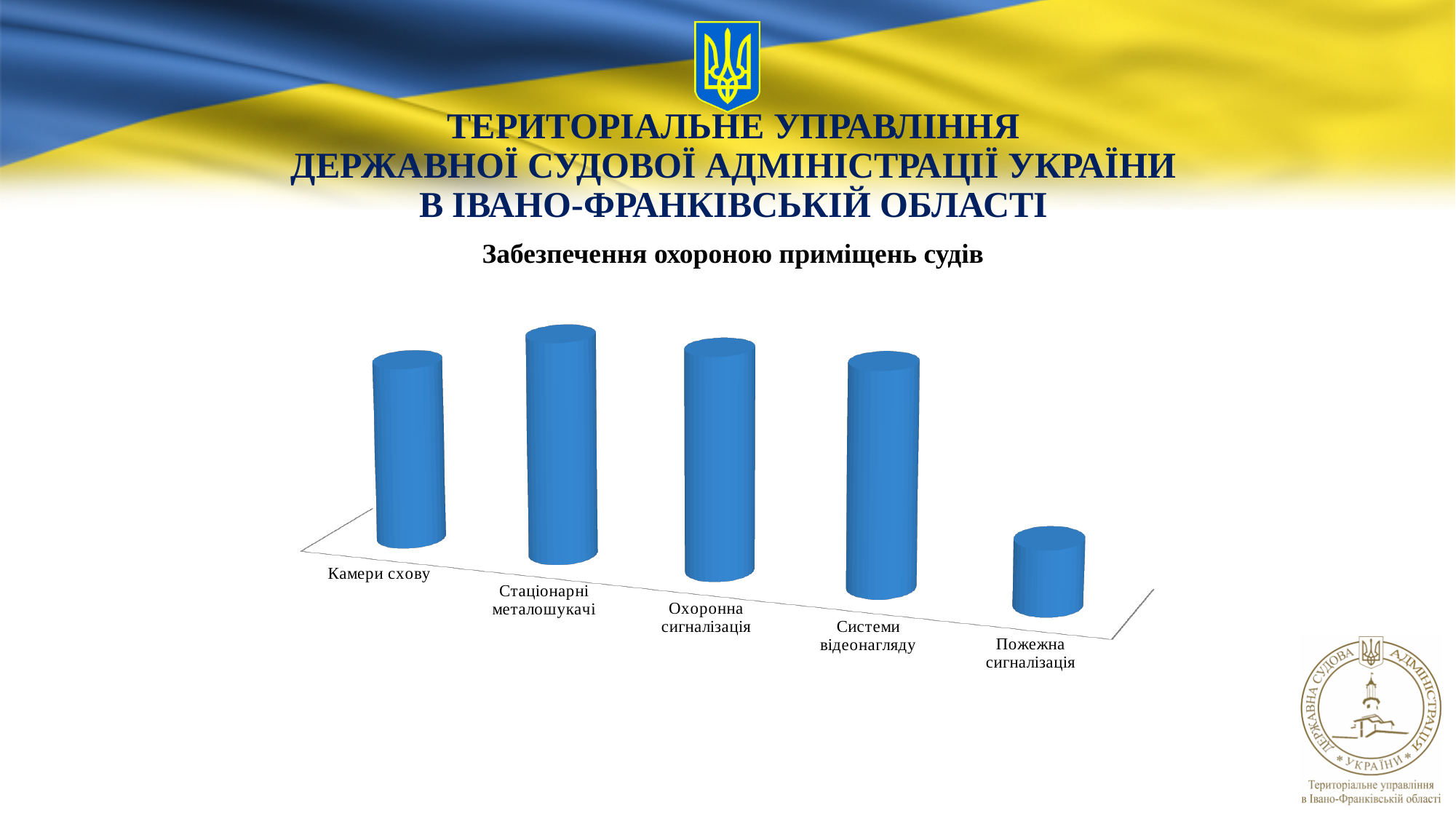
Which is larger, the value for Охоронна сигналізація or the value for Пожежна сигналізація? Охоронна сигналізація Which category has the lowest value in the chart? Пожежна сигналізація Which is larger, the value for Камери схову or the value for Пожежна сигналізація? Камери схову What kind of chart is shown on the slide? bar chart Which is larger, the value for Стаціонарні металошукачі or the value for Камери схову? Стаціонарні металошукачі What is the label of the first category on the left of the chart? Камери схову How many categories are shown in the chart? 5 What colour are the bars in the chart? blue What is the title of the chart? Забезпечення охороною приміщень судів